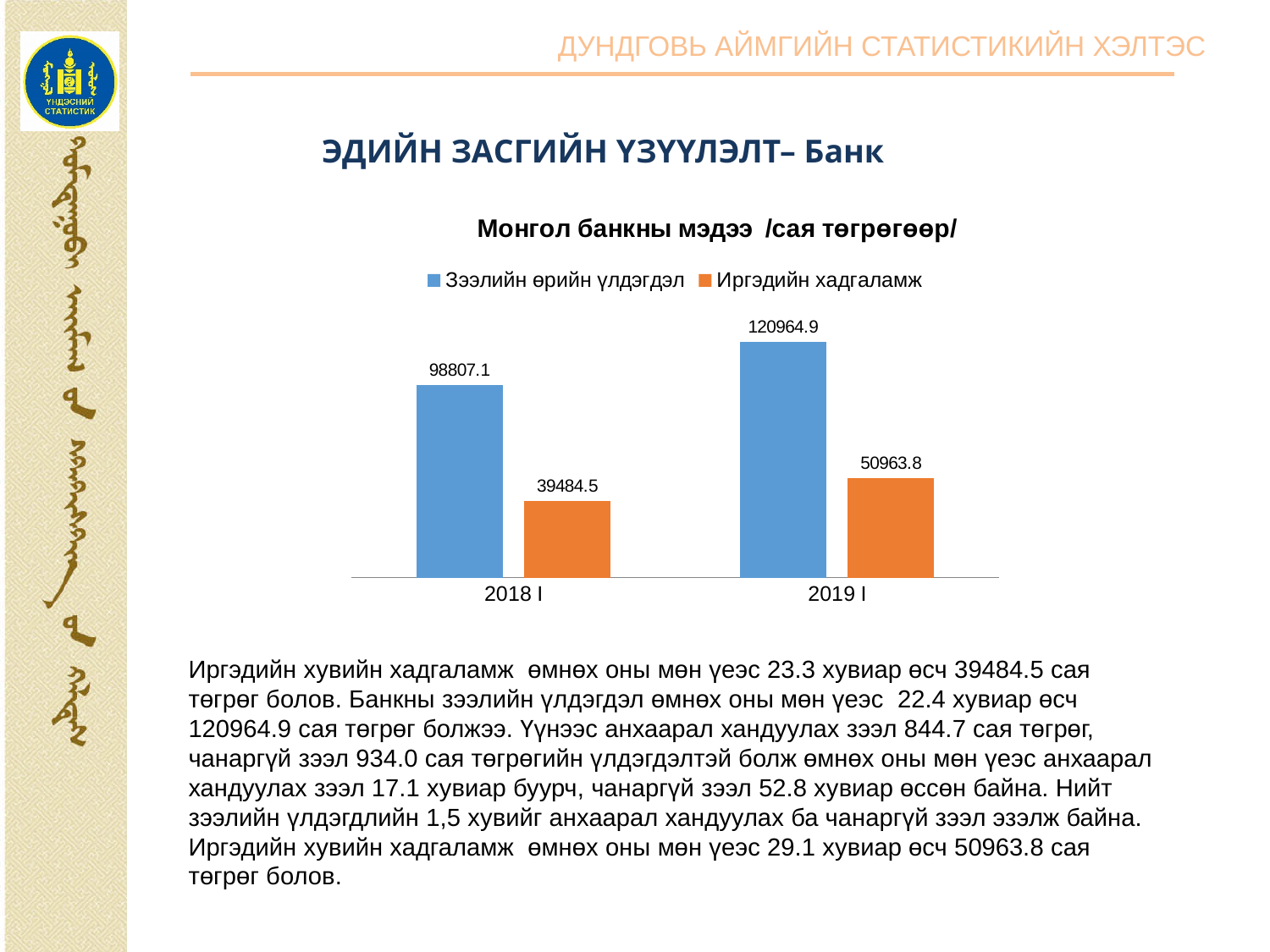
Which is larger in 2018 I, Зээлийн өрийн үлдэгдэл or Иргэдийн хадгаламж? Зээлийн өрийн үлдэгдэл What is the value of Иргэдийн хадгаламж for 2019 I? 50963.8 What is the value of Иргэдийн хадгаламж for 2018 I? 39484.5 What is the difference between Зээлийн өрийн үлдэгдэл and Иргэдийн хадгаламж in 2019 I? 70001.1 By how much did Зээлийн өрийн үлдэгдэл increase from 2018 I to 2019 I? 22157.8 Which period has the lowest value for Иргэдийн хадгаламж? 2018 I What is the value of Зээлийн өрийн үлдэгдэл for 2019 I? 120964.9 How many series does the legend list? 2 Which period has the highest value for Зээлийн өрийн үлдэгдэл? 2019 I What kind of chart is shown on the slide? Bar chart Does Иргэдийн хадгаламж rise or fall from 2018 I to 2019 I? Rise What is the value of Зээлийн өрийн үлдэгдэл for 2018 I? 98807.1